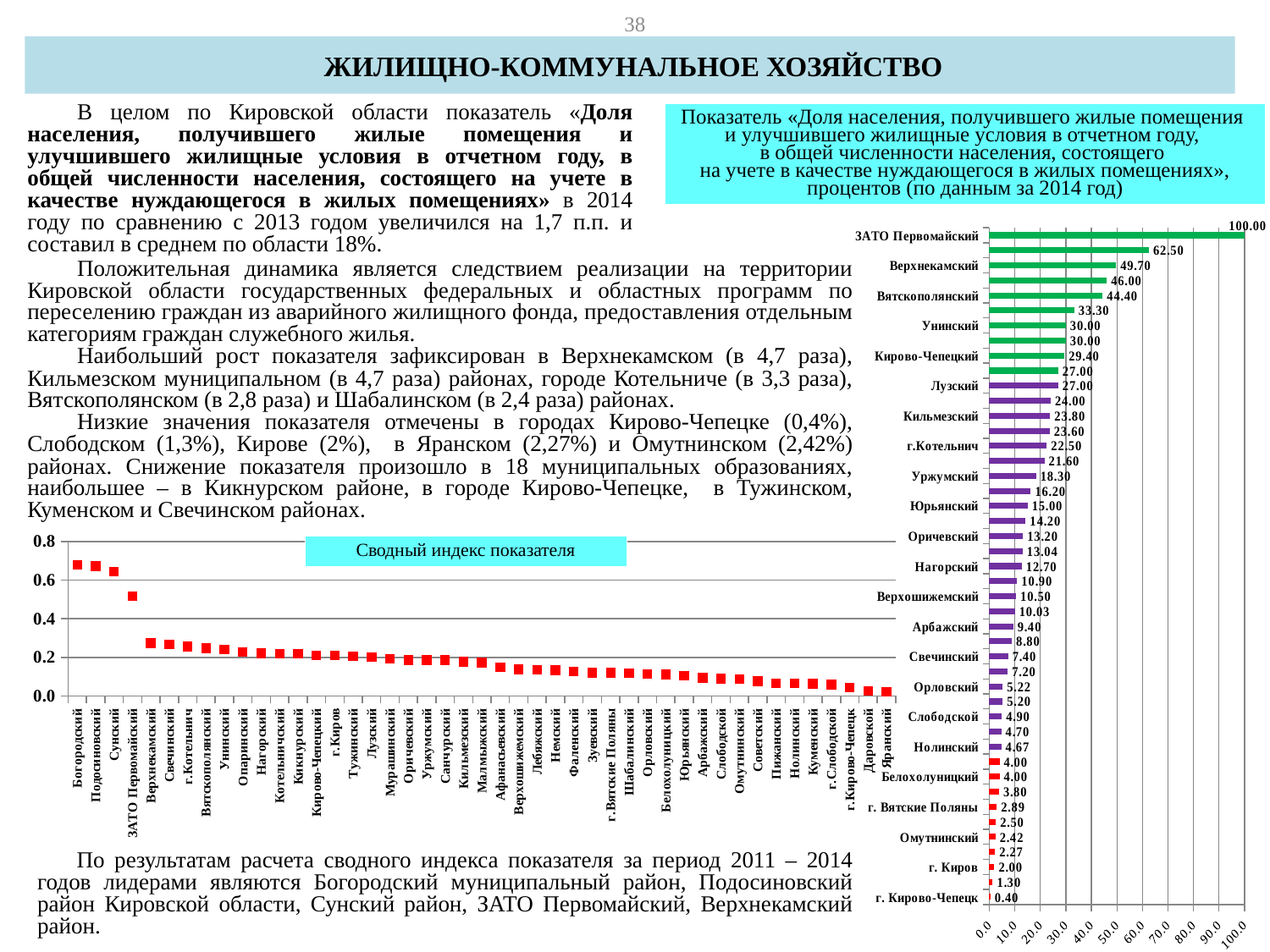
On the bottom-left chart titled 'Сводный индекс показателя', is the value for Богородский greater or less than 0.6? greater On the right-hand bar chart, which is larger: the value for Уржумский or the value for Юрьянский? Уржумский On the right-hand bar chart, what is the value for Верхнекамский? 49.70 What kind of chart is the right-hand chart? bar chart On the bottom-left chart titled 'Сводный индекс показателя', do the values rise or fall from left to right along the x axis? fall On the right-hand bar chart, which category has the highest value? ЗАТО Первомайский On the right-hand bar chart, is the value for Кильмезский greater or less than 20.0? greater On the right-hand bar chart, what is the difference between the values for Верхнекамский and Вятскополянский? 5.30 On the right-hand bar chart, what is the value for ЗАТО Первомайский? 100.00 On the right-hand bar chart, what is the value for г. Кирово-Чепецк? 0.40 On the right-hand bar chart, which category has the lowest value? г. Кирово-Чепецк On the right-hand bar chart, what is the value for Омутнинский? 2.42